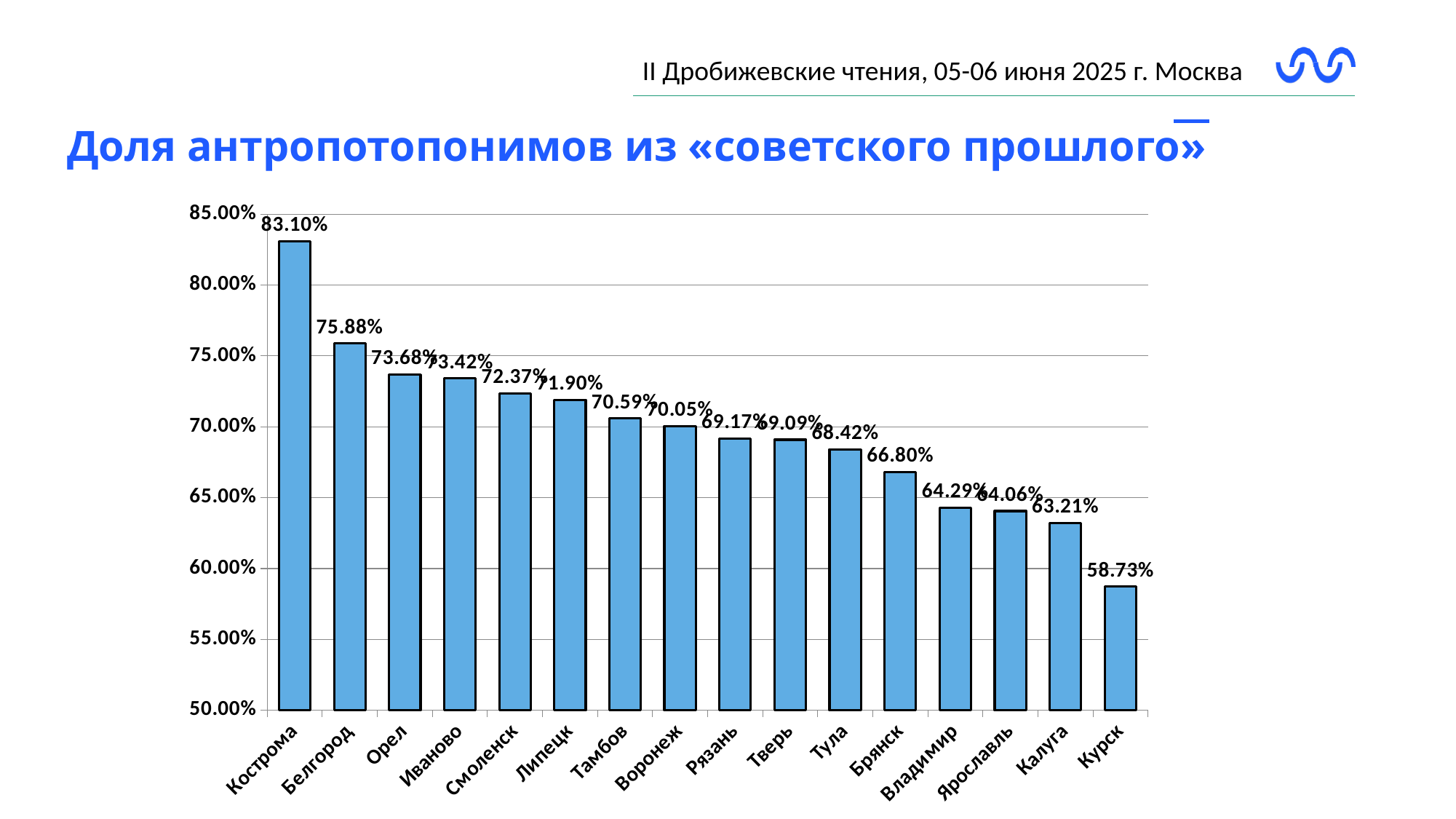
What kind of chart is shown on the slide? Bar chart What is the difference between the values for Кострома and Курск? 24.37 percentage points How many cities are shown on the x axis of the chart? 16 Which city has the lowest value? Курск Which city has the highest value? Кострома Do the values rise or fall from left to right along the x axis? Fall What is the value for Воронеж? 70.05% Which has a larger value, Белгород or Тула? Белгород What is the title of the chart on the slide? Доля антропотопонимов из «советского прошлого» What is the value for Брянск? 66.80% What is the value for Курск? 58.73% What is the value for Кострома? 83.10%